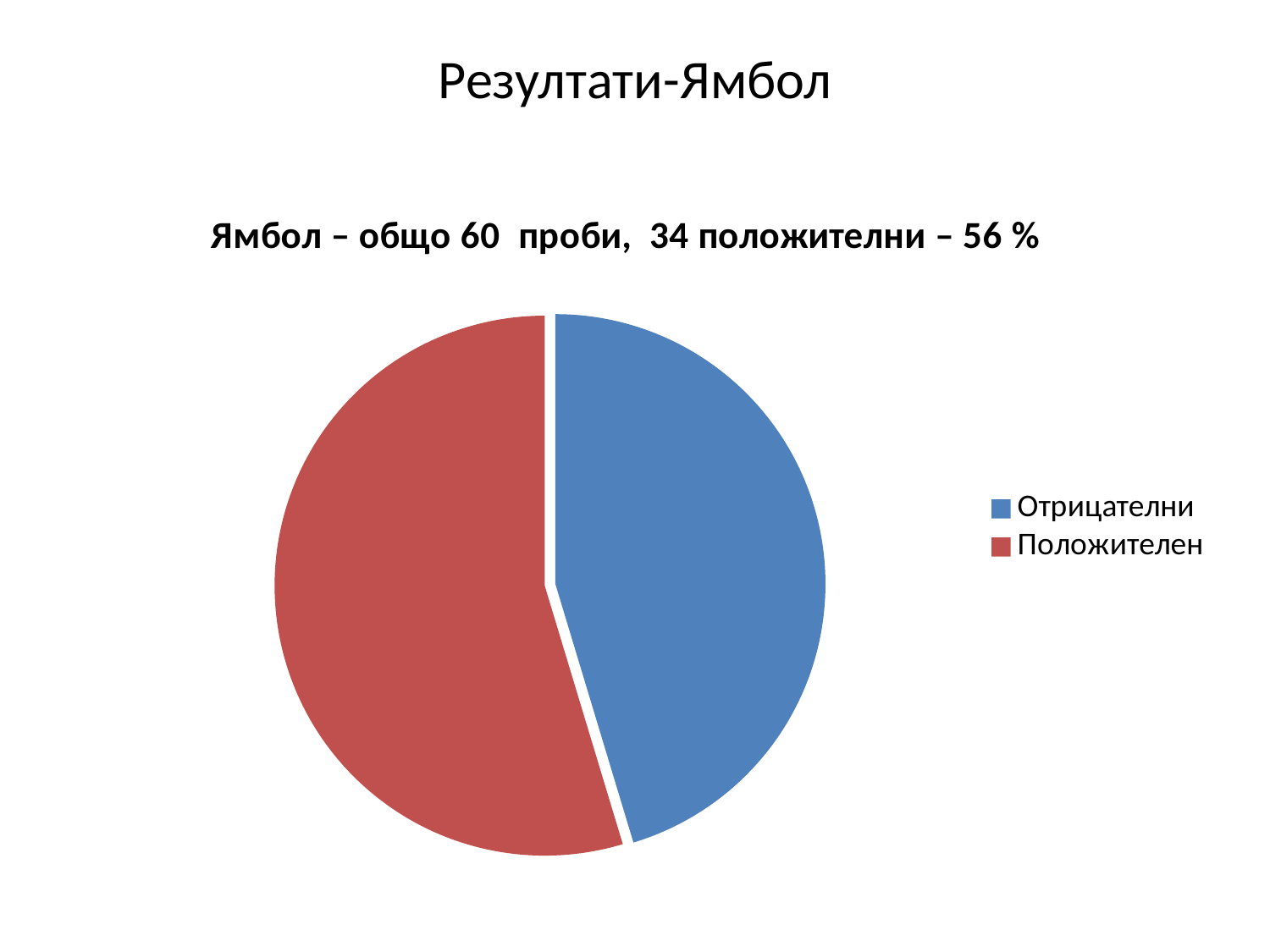
Which category has the smallest slice in the pie chart? Отрицателни What colour is the Отрицателни slice in the pie chart? blue According to the chart title, how many samples in total (общо проби) were tested in Ямбол? 60 How many entries does the legend of the pie chart list? 2 What is the title of the pie chart? Ямбол – общо 60 проби, 34 положителни – 56 % What kind of chart is shown on the slide? pie chart According to the chart title, what share of the samples were positive (положителни)? 56 % Which slice of the pie chart is larger, Отрицателни or Положителен? Положителен According to the chart title, how many samples were positive (положителни)? 34 How many slices does the pie chart have? 2 Which category has the largest slice in the pie chart? Положителен